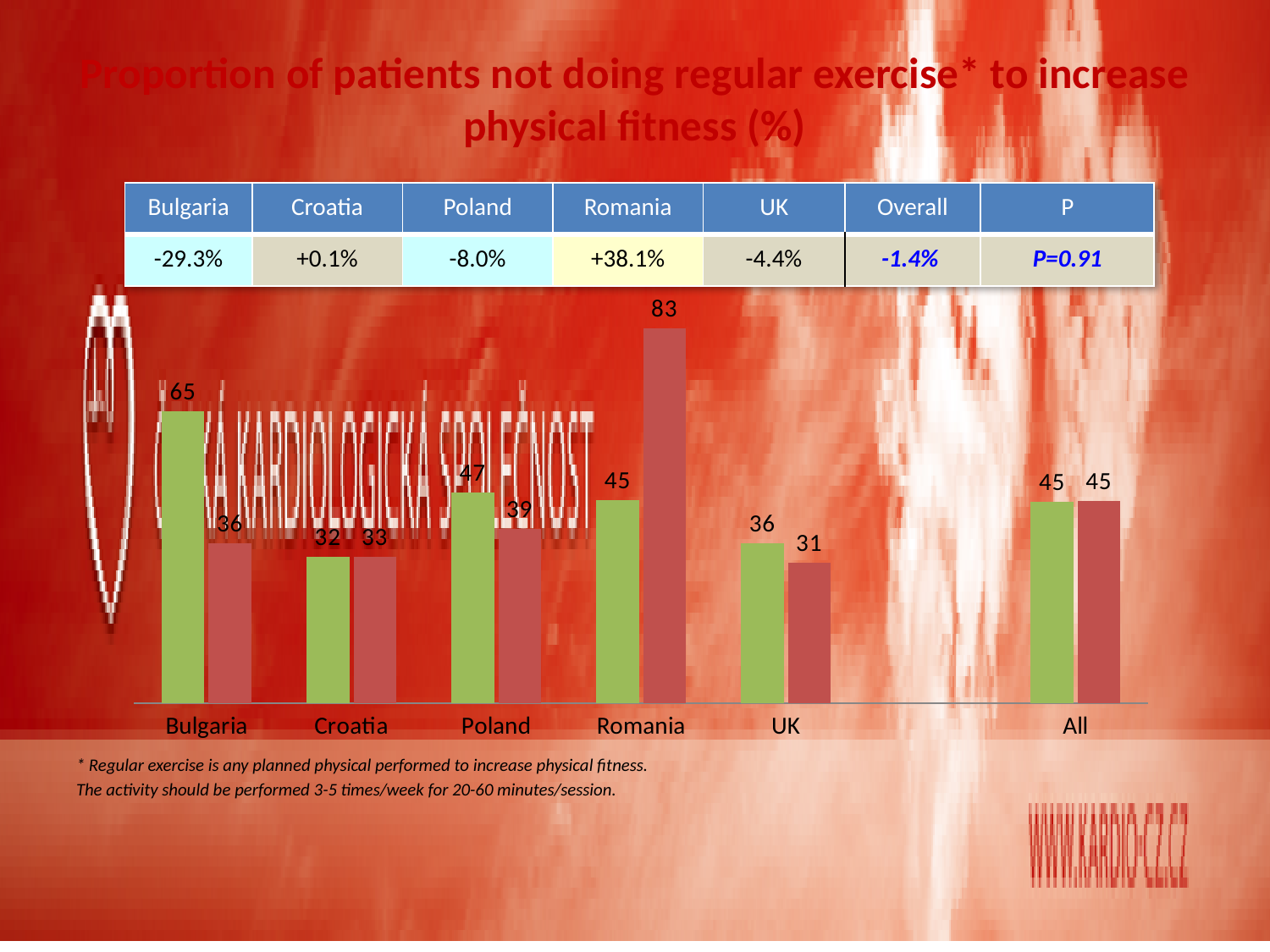
What is the difference between the green and red bars for Bulgaria? 29 Which category has the highest red bar? Romania Which is larger for UK, the green bar or the red bar? the green bar What is the value of the red bar for Romania? 83 What is the value of the red bar for UK? 31 What is the value of the green bar for Bulgaria? 65 What is the difference between the red and green bars for Romania? 38 What kind of chart is shown on the slide? bar chart Which category has the lowest green bar? Croatia How many categories are shown on the x axis of the chart? 6 What is the value of the green bar for Poland? 47 What are the values of the green and red bars for All? 45 and 45